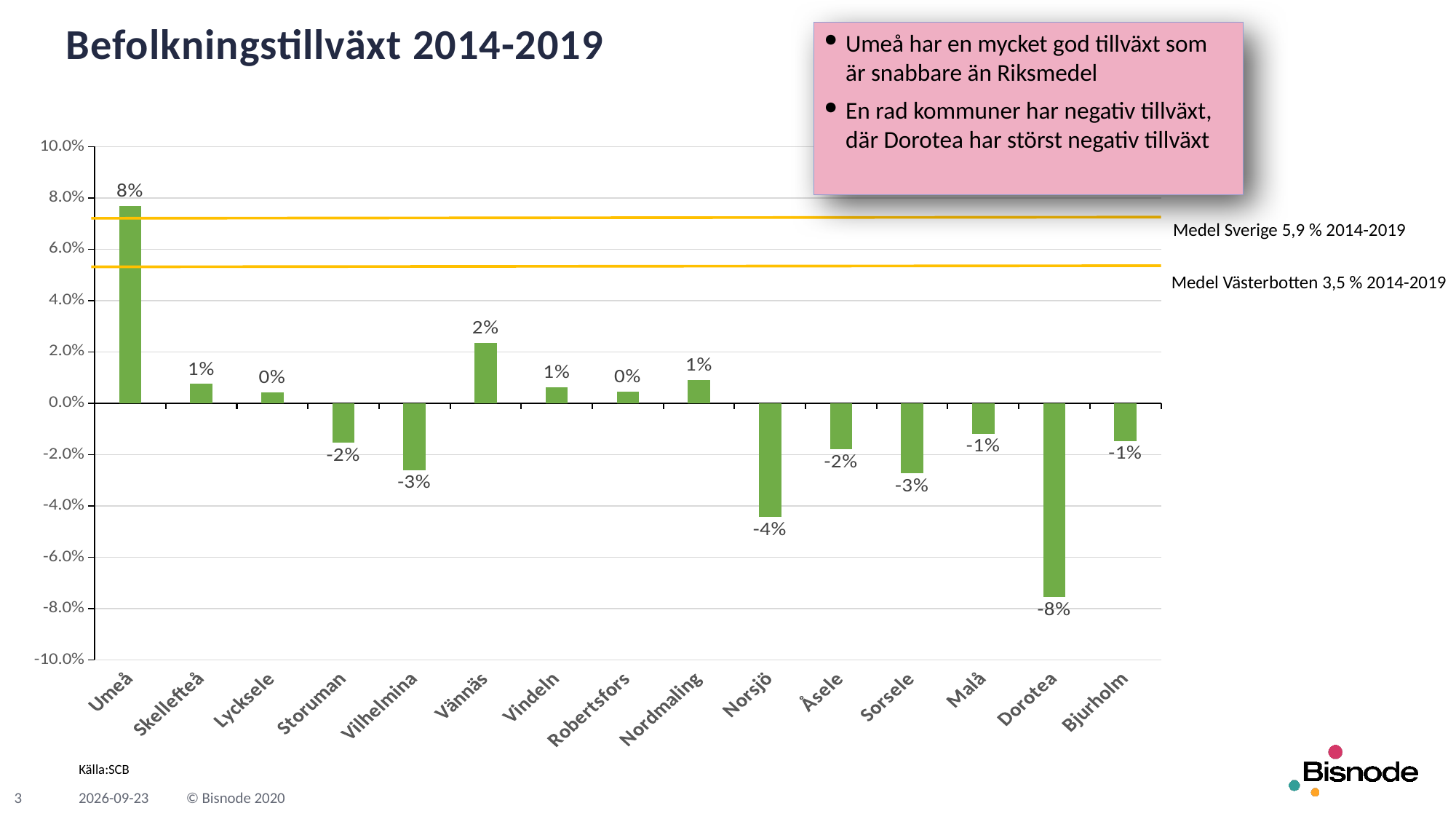
What is the difference between the labelled values for Umeå and Vännäs? 6 percentage points What is the population growth value shown for Umeå? 8% Which municipality has the highest population growth in the chart? Umeå What is the value shown for Vännäs? 2% Is the value for Umeå greater or less than 6.0%? greater What kind of chart is shown on the slide? bar chart Which municipality has the lowest population growth in the chart? Dorotea What is the value shown for Norsjö? -4% How many municipalities are shown on the x axis? 15 What value does the 'Medel Sverige' reference line label state for 2014-2019? 5,9 % Which has the larger value, Vilhelmina or Norsjö? Vilhelmina What is the value shown for Dorotea? -8%